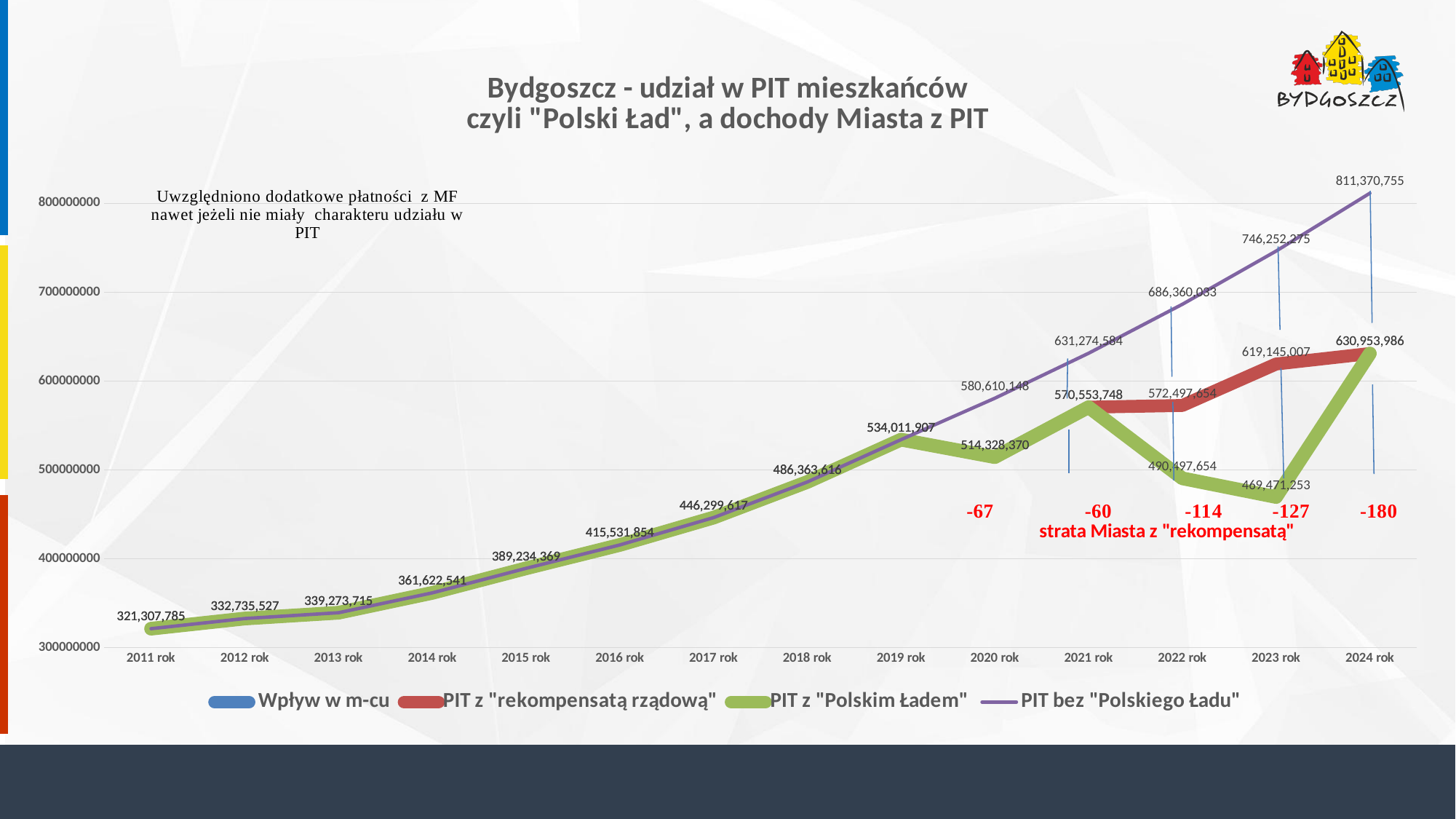
What is the value shown for 2011 rok? 321,307,785 Does the PIT bez "Polskiego Ładu" line rise or fall from 2011 rok to 2024 rok? rise What is the difference between PIT bez "Polskiego Ładu" and PIT z "Polskim Ładem" in 2024 rok? 180,416,769 How many series does the legend list? 4 How many years are shown on the x axis? 14 What is the difference between PIT z "rekompensatą rządową" and PIT z "Polskim Ładem" in 2022 rok? 82,000,000 What is the value of PIT bez "Polskiego Ładu" for 2024 rok? 811,370,755 What kind of chart is shown on the slide? line chart What is the value of PIT z "Polskim Ładem" for 2023 rok? 469,471,253 What is the value of PIT bez "Polskiego Ładu" for 2020 rok? 580,610,148 In which year does the PIT bez "Polskiego Ładu" line reach its highest value? 2024 rok In 2022 rok, which is larger: PIT z "rekompensatą rządową" or PIT z "Polskim Ładem"? PIT z "rekompensatą rządową"